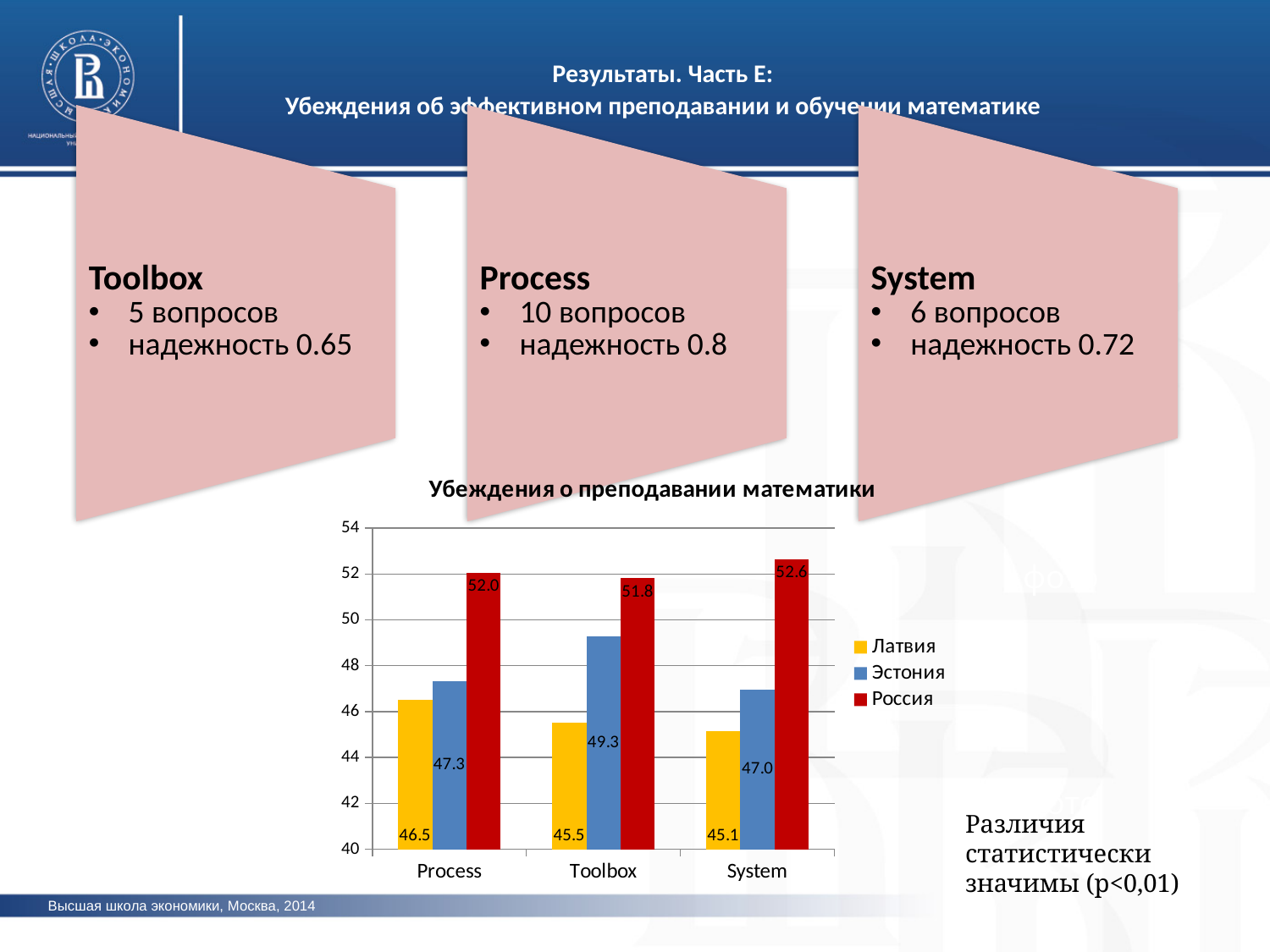
Is the value for Эстония in the System category greater or less than 48? less What is the value for Эстония in the Toolbox category? 49.3 What is the chart's title? Убеждения о преподавании математики What is the difference between Россия and Латвия in the Toolbox category? 6.3 What type of chart is shown on the slide? bar chart In which category does Россия have its highest value? System What is the value for Россия in the Process category? 52.0 How many series does the legend list? 3 Which is larger in the Process category: Эстония or Латвия? Эстония What is the value for Латвия in the System category? 45.1 How many categories are shown on the x axis? 3 In which category does Латвия have its lowest value? System